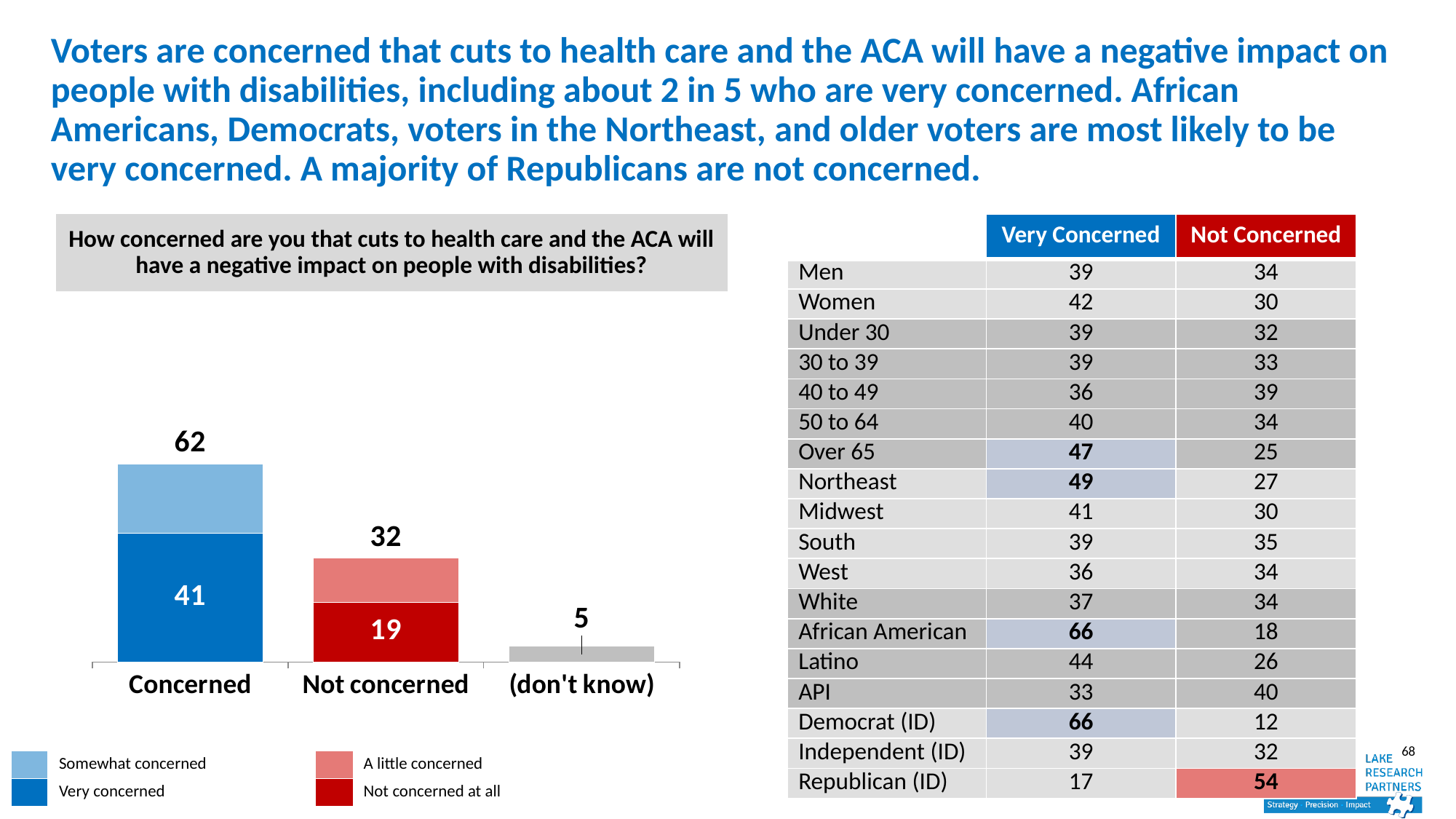
Based on the printed values, what is the value of the Somewhat concerned segment of the Concerned bar? 21 What is the total value shown above the Concerned bar? 62 Which category has the shortest bar in the chart? (don't know) What value is shown for the Not concerned at all segment of the Not concerned bar? 19 Which is larger: the Very concerned segment or the Not concerned at all segment? Very concerned What is the difference between the Concerned total and the Not concerned total? 30 What is the total value shown above the Not concerned bar? 32 How many categories are shown along the x axis of the bar chart? 3 What kind of chart is shown on the left of the slide? Stacked bar chart What value is shown for the (don't know) bar? 5 Which category has the tallest bar in the chart? Concerned What value is shown for the Very concerned segment of the Concerned bar? 41